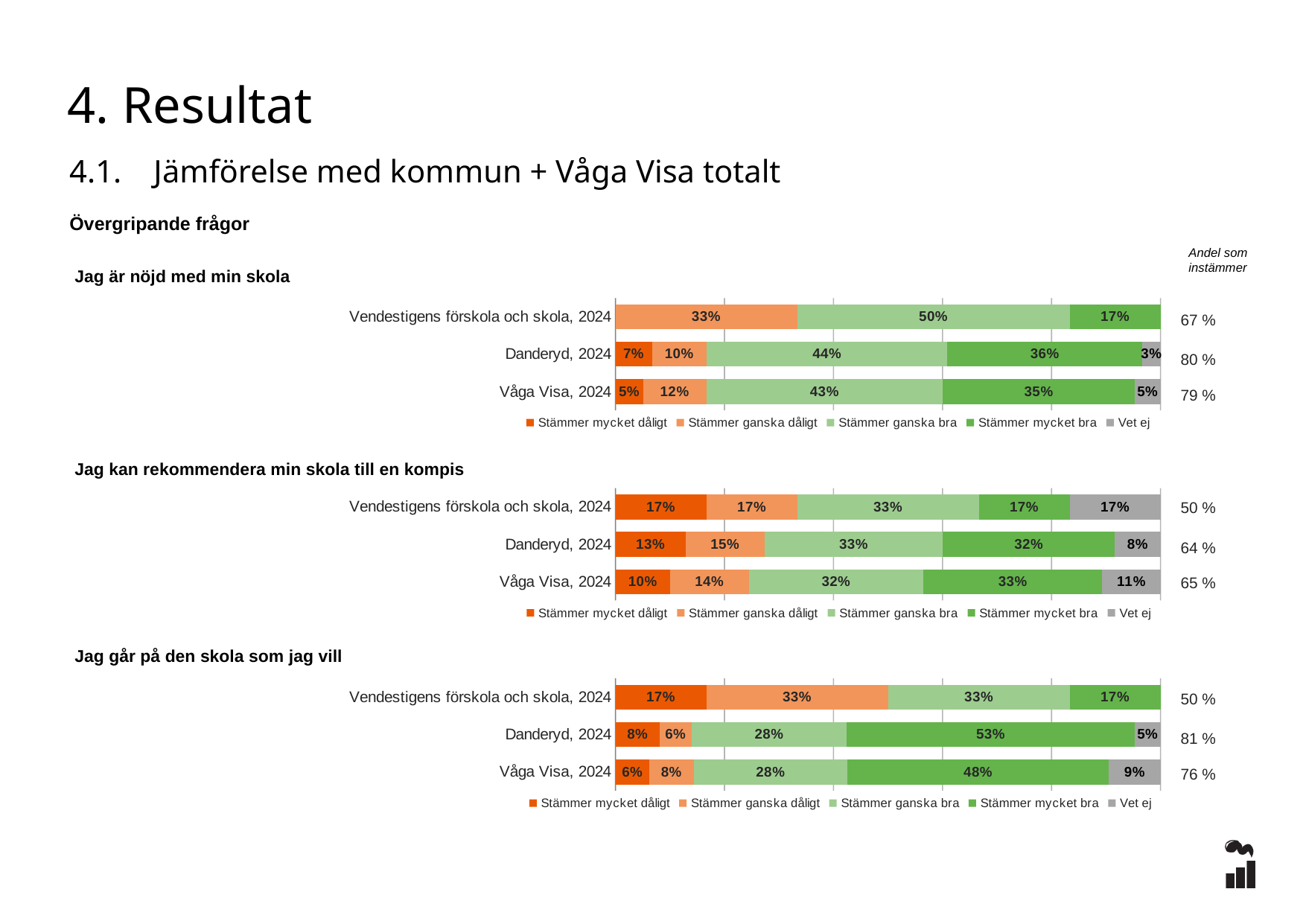
In the chart 'Jag kan rekommendera min skola till en kompis', what is the difference between the 'Stämmer mycket bra' values for Danderyd, 2024 and Vendestigens förskola och skola, 2024? 15% In the chart 'Jag går på den skola som jag vill', which category has the lowest 'Andel som instämmer'? Vendestigens förskola och skola, 2024 In the chart 'Jag kan rekommendera min skola till en kompis', which has the larger 'Stämmer mycket dåligt' value: Danderyd, 2024 or Våga Visa, 2024? Danderyd, 2024 In the chart 'Jag är nöjd med min skola', what is the 'Stämmer mycket bra' value for Danderyd, 2024? 36% In the chart 'Jag är nöjd med min skola', which category has the highest 'Andel som instämmer'? Danderyd, 2024 How many categories (bars) are shown in the chart 'Jag kan rekommendera min skola till en kompis'? 3 In the chart 'Jag går på den skola som jag vill', what is the difference between the 'Stämmer mycket bra' values for Danderyd, 2024 and Våga Visa, 2024? 5% In the chart 'Jag kan rekommendera min skola till en kompis', what is the 'Vet ej' value for Vendestigens förskola och skola, 2024? 17% How many series does the legend of the chart 'Jag är nöjd med min skola' list? 5 What kind of chart is 'Jag går på den skola som jag vill'? Stacked bar chart In the chart 'Jag är nöjd med min skola', what is the 'Stämmer ganska bra' value for Vendestigens förskola och skola, 2024? 50% In the chart 'Jag går på den skola som jag vill', what is the 'Stämmer mycket bra' value for Danderyd, 2024? 53%